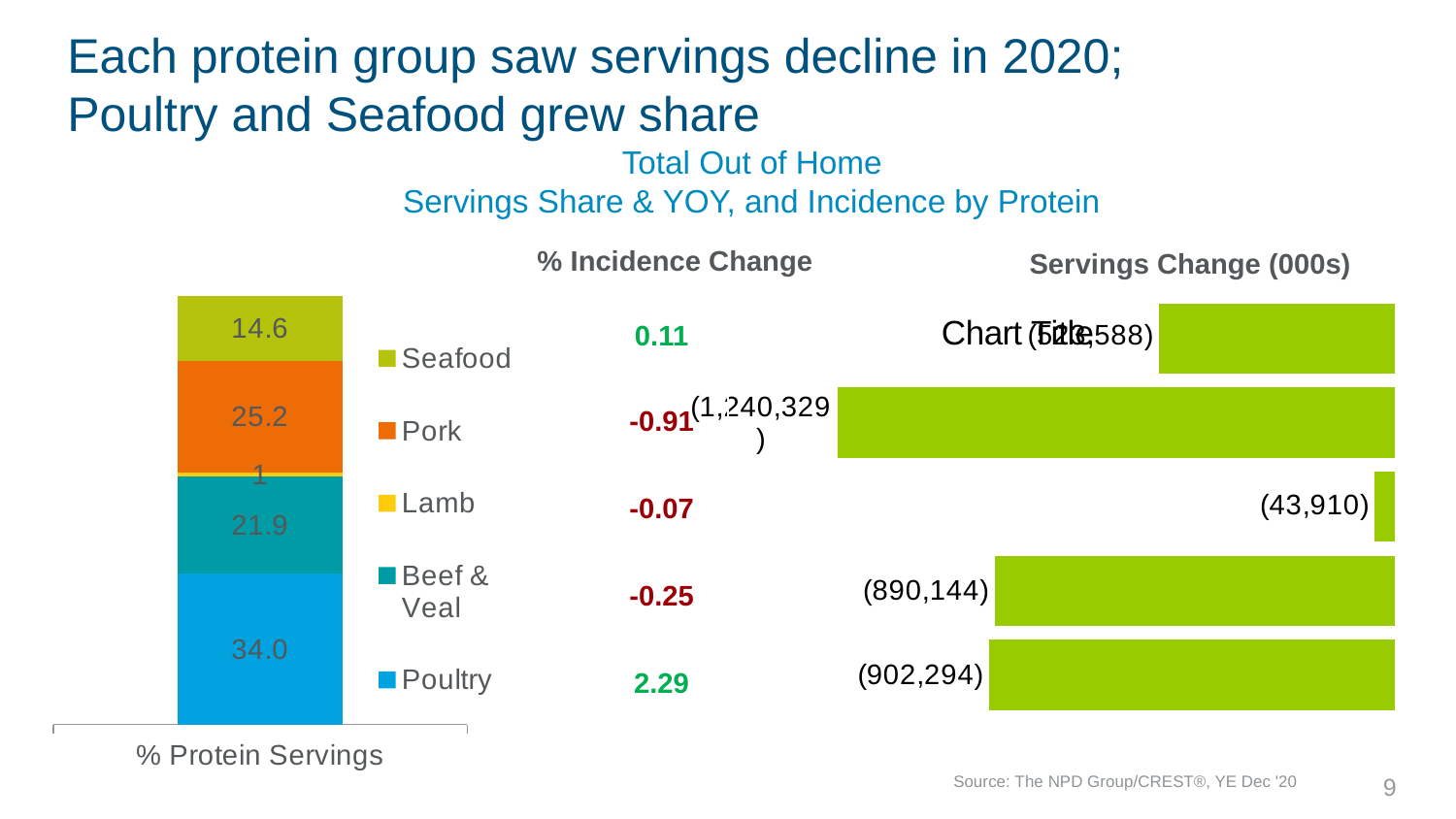
In the % Protein Servings stacked bar chart, which protein has the smallest share? Lamb In the % Protein Servings stacked bar chart, what is the value for Poultry? 34.0 In the Servings Change (000s) chart, what is the value for Pork? (1,240,329) How many entries does the legend of the % Protein Servings chart list? 5 In the Servings Change (000s) chart, what is the value for Lamb? (43,910) In the % Protein Servings stacked bar chart, which protein has the largest share? Poultry In the % Protein Servings stacked bar chart, what is the value for Pork? 25.2 In the Servings Change (000s) chart, what is the value for Poultry? (902,294) In the % Protein Servings stacked bar chart, which is larger, Pork or Seafood? Pork In the % Protein Servings stacked bar chart, what is the difference between the Poultry and Beef & Veal values? 12.1 In the % Protein Servings stacked bar chart, what is the value for Seafood? 14.6 What kind of chart is the % Protein Servings chart? Stacked bar chart